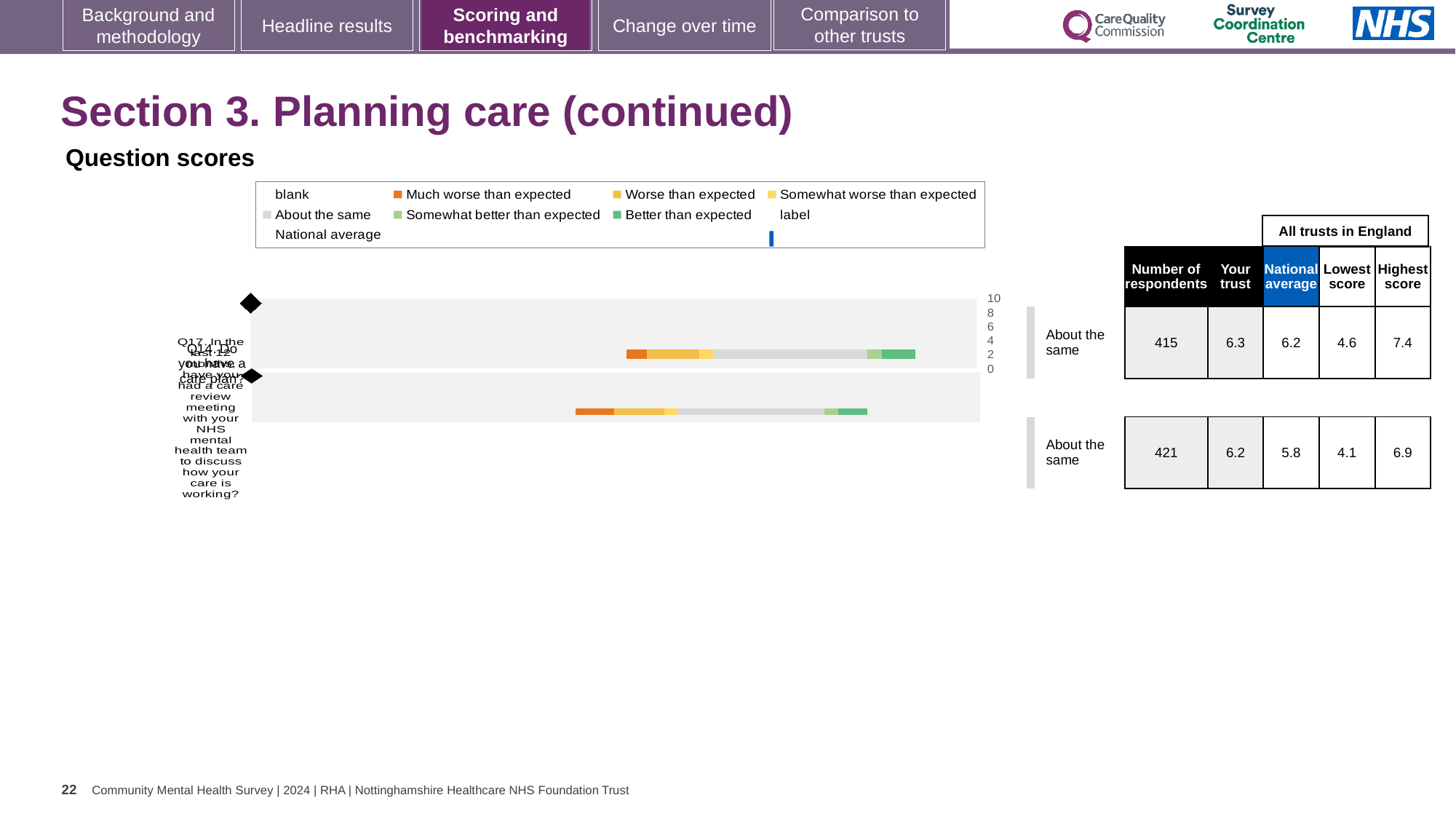
In the table next to the chart, what is the difference between the highest and lowest score for the second row (Q17)? 2.8 What kind of chart is shown under 'Question scores'? bar chart In the table next to the chart, what is the 'Your trust' score for the second row (Q17)? 6.2 In the table next to the chart, what is the national average for the first row (Q14)? 6.2 In the table next to the chart, what is the highest score among all trusts in England for the first row (Q14)? 7.4 What colour does the legend use for 'Much worse than expected'? orange In the table next to the chart, what is the national average for the second row (Q17)? 5.8 In the table next to the chart, what is the 'Your trust' score for the first row (Q14)? 6.3 In the table next to the chart, how many respondents are listed for the second row (Q17)? 421 What benchmark category is shown beside each bar in the chart? About the same In the table next to the chart, which row has more respondents, the first (Q14) or the second (Q17)? the second (Q17) How many question bars are plotted in the chart? 2